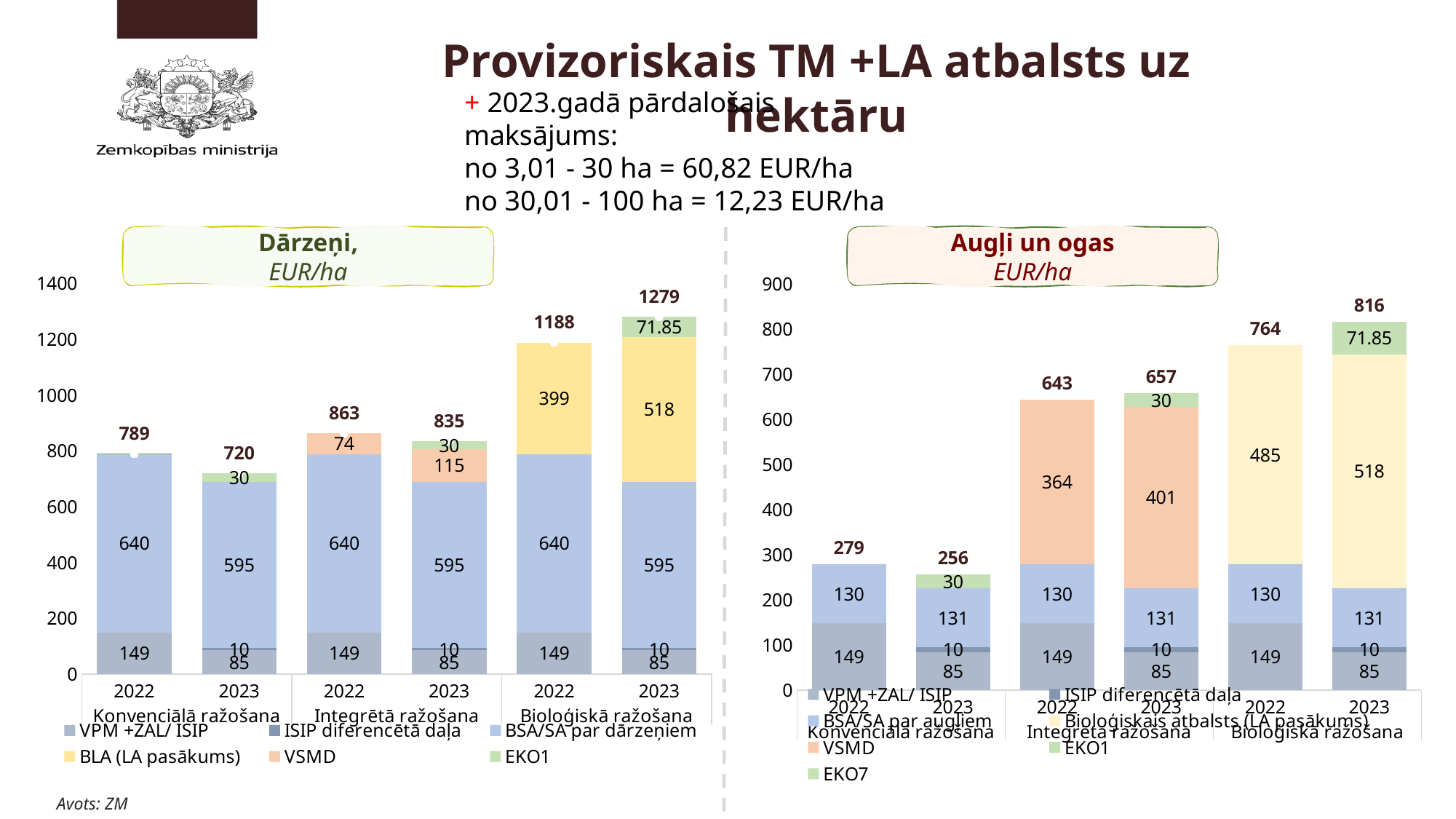
In the 'Augļi un ogas EUR/ha' chart, how many bars are plotted? 6 In the 'Dārzeņi, EUR/ha' chart, what is the difference between the Integrētā ražošana totals for 2022 and 2023? 28 In the 'Dārzeņi, EUR/ha' chart, which bar has the lowest total? Konvenciālā ražošana 2023 In the 'Dārzeņi, EUR/ha' chart, what is the BLA (LA pasākums) value for Bioloģiskā ražošana in 2022? 399 In the 'Augļi un ogas EUR/ha' chart, is the Bioloģiskā ražošana 2022 total larger or smaller than the Integrētā ražošana 2022 total? larger In the 'Augļi un ogas EUR/ha' chart, what is the total for Konvencionālā ražošana in 2022? 279 In the 'Dārzeņi, EUR/ha' chart, what is the total for Bioloģiskā ražošana in 2023? 1279 In the 'Augļi un ogas EUR/ha' chart, which bar has the highest total? Bioloģiskā ražošana 2023 In the 'Dārzeņi, EUR/ha' chart, how many series does the legend list? 6 In the 'Augļi un ogas EUR/ha' chart, how many series does the legend list? 7 What kind of chart is the 'Augļi un ogas EUR/ha' chart? Stacked bar chart In the 'Augļi un ogas EUR/ha' chart, what is the VSMD value for Integrētā ražošana in 2023? 401